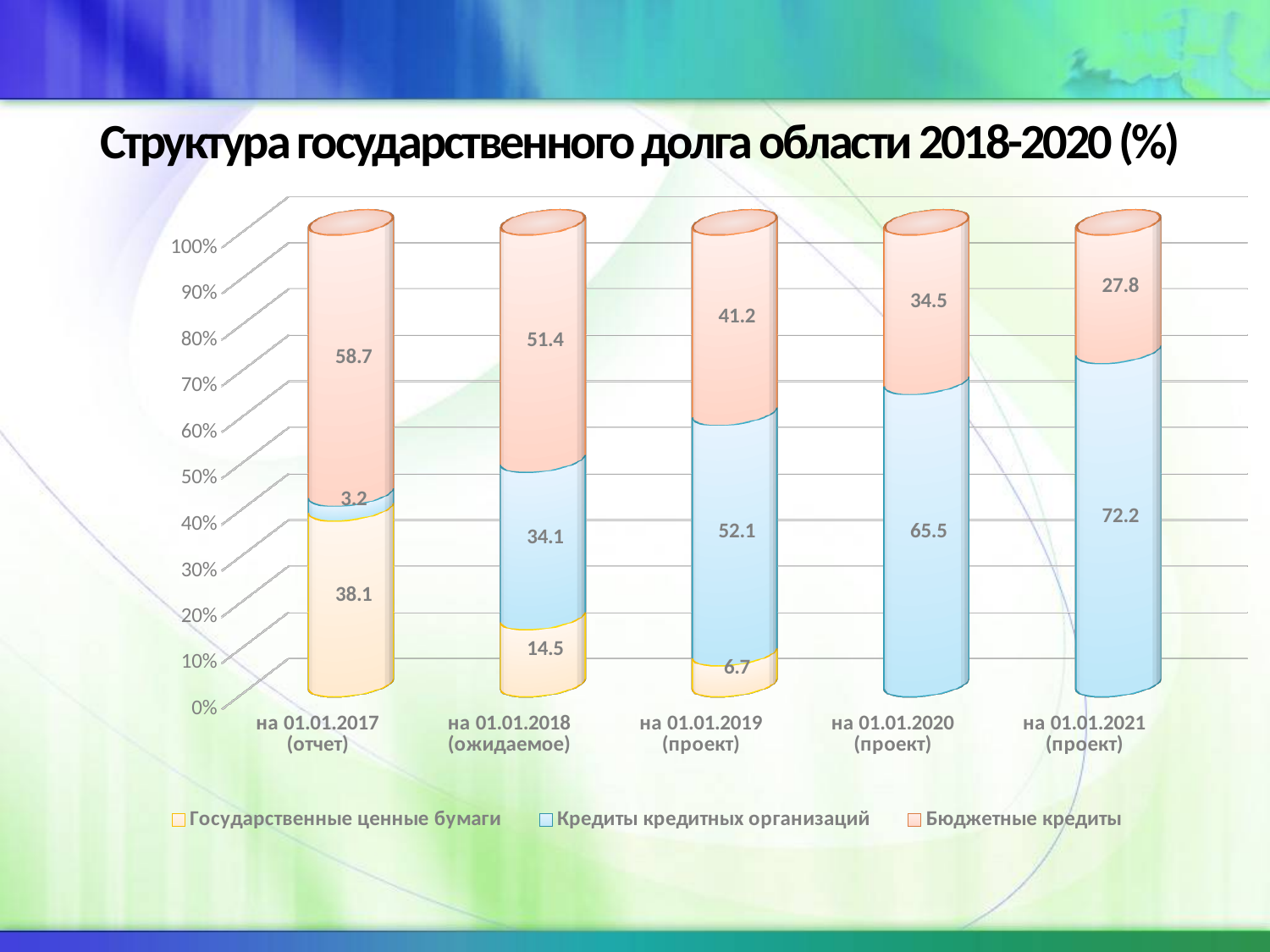
What is the difference between the Бюджетные кредиты values for на 01.01.2018 (ожидаемое) and на 01.01.2021 (проект)? 23.6 What is the value of Государственные ценные бумаги for на 01.01.2018 (ожидаемое)? 14.5 Which category has the lowest value for Кредиты кредитных организаций? на 01.01.2017 (отчет) What is the value of Бюджетные кредиты for на 01.01.2017 (отчет)? 58.7 What kind of chart is shown on the slide? Stacked bar chart What is the value of Кредиты кредитных организаций for на 01.01.2019 (проект)? 52.1 What is the value of Кредиты кредитных организаций for на 01.01.2021 (проект)? 72.2 How many categories are shown on the x axis? 5 How many series does the legend list? 3 Do the values for Бюджетные кредиты rise or fall from на 01.01.2017 to на 01.01.2021? Fall Which category has the highest value for Бюджетные кредиты? на 01.01.2017 (отчет) Which is larger for на 01.01.2020 (проект): Кредиты кредитных организаций or Бюджетные кредиты? Кредиты кредитных организаций